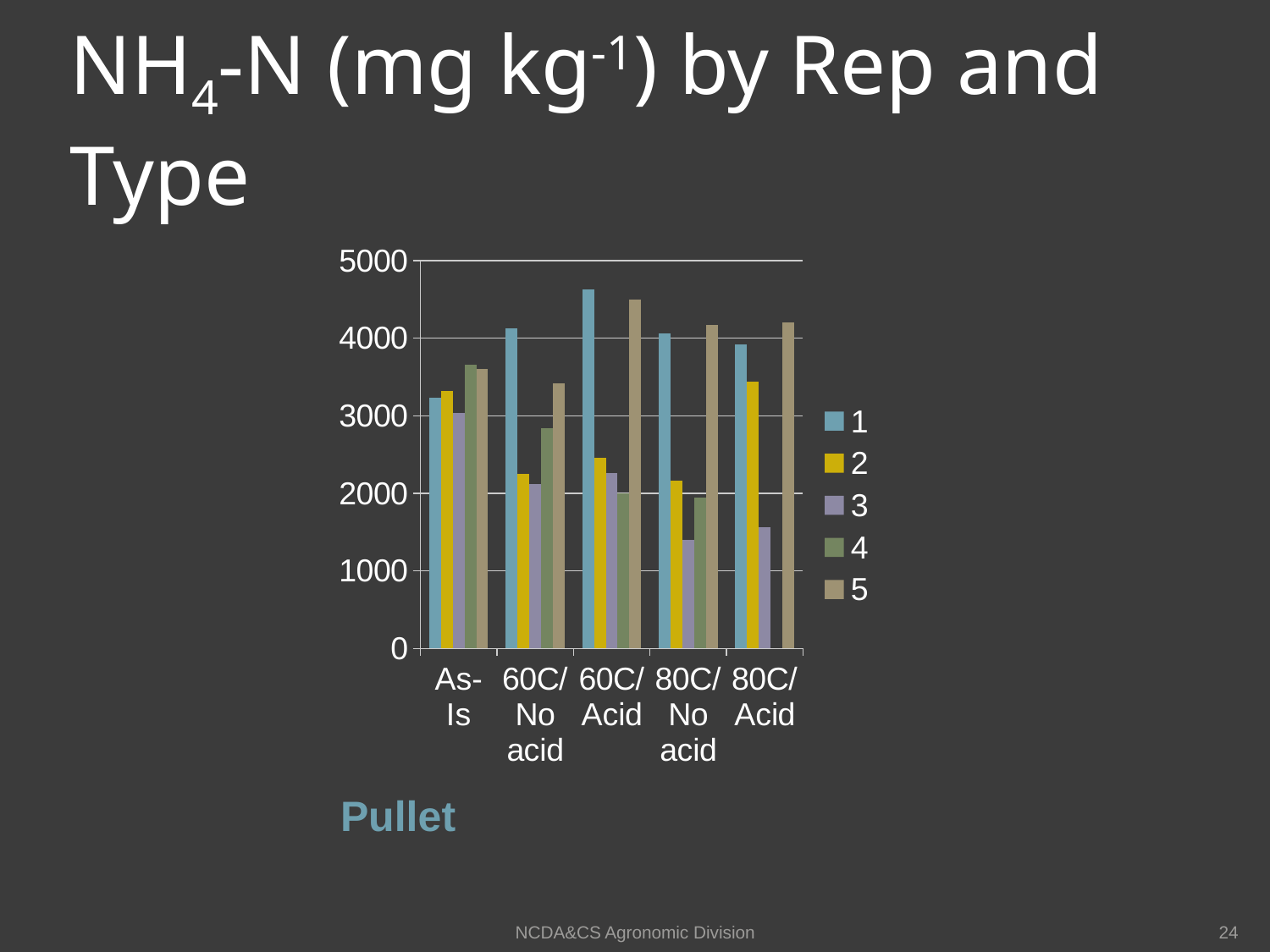
Is the value for series 3 in the 80C/No acid category greater or less than 2000? less In the 60C/Acid category, which is larger: the value for series 1 or the value for series 2? series 1 Which series has the highest value in the 60C/No acid category? 1 Is the value for series 5 in the As-Is category greater or less than 3000? greater Is the value for series 2 in the 60C/No acid category greater or less than 3000? less In the As-Is category, which is larger: the value for series 4 or the value for series 3? series 4 What kind of chart is shown on the slide? bar chart How many series does the legend list? 5 What label appears below the chart? Pullet Which series has the lowest value in the 80C/No acid category? 3 How many categories are shown along the x axis? 5